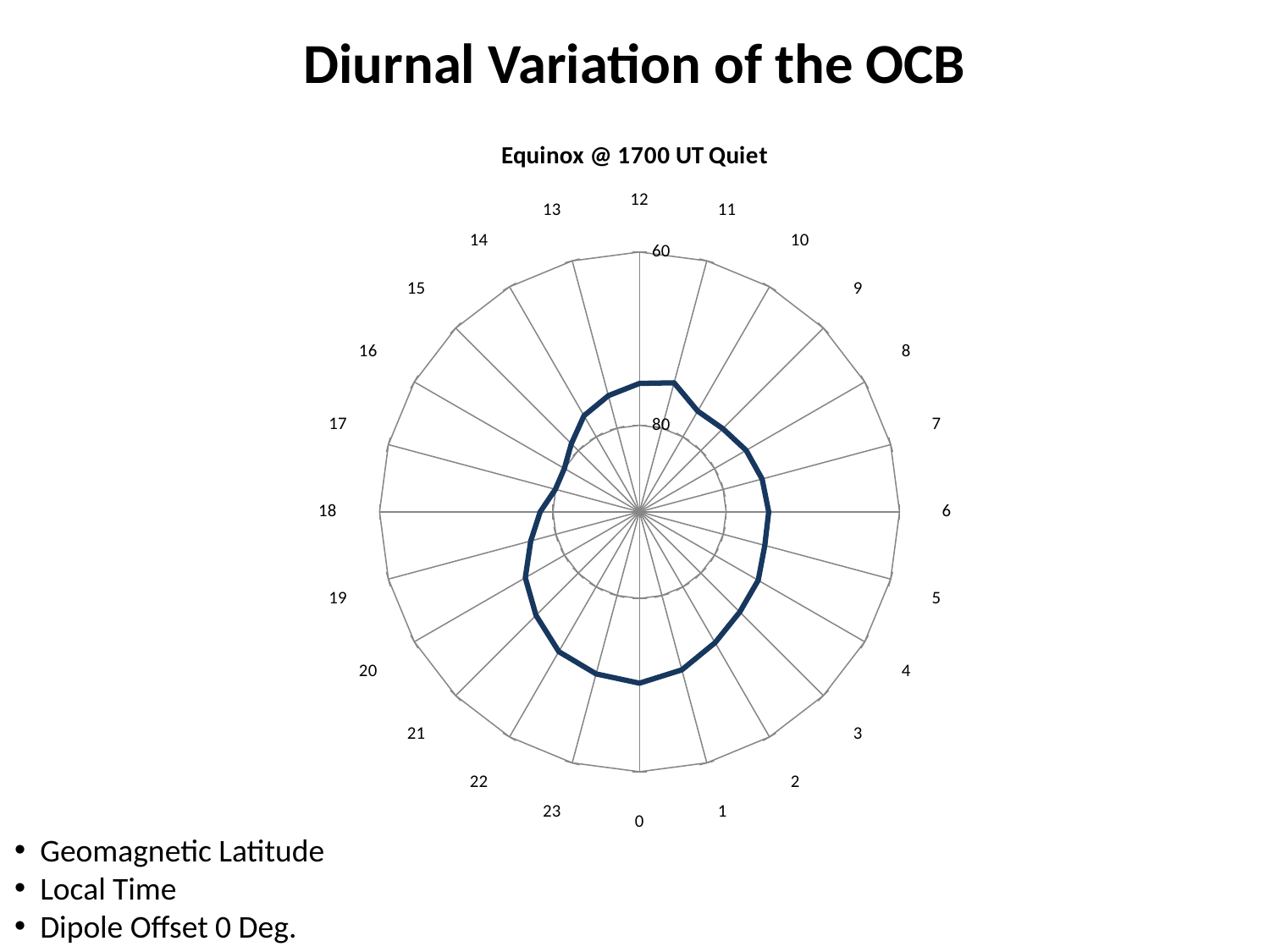
Is the value at hour 3 greater or less than 80? less What kind of chart is shown on the slide? Radar chart How many data series are plotted on the chart? 1 What is the title of the chart? Equinox @ 1700 UT Quiet Which two values are labelled on the radial axis of the chart? 60 and 80 Is the value at hour 12 greater or less than 80? less Is the value at hour 18 greater or less than 60? greater How many hour categories are plotted around the chart? 24 Which hour's point lies closer to the 60 ring, hour 0 or hour 12? Hour 0